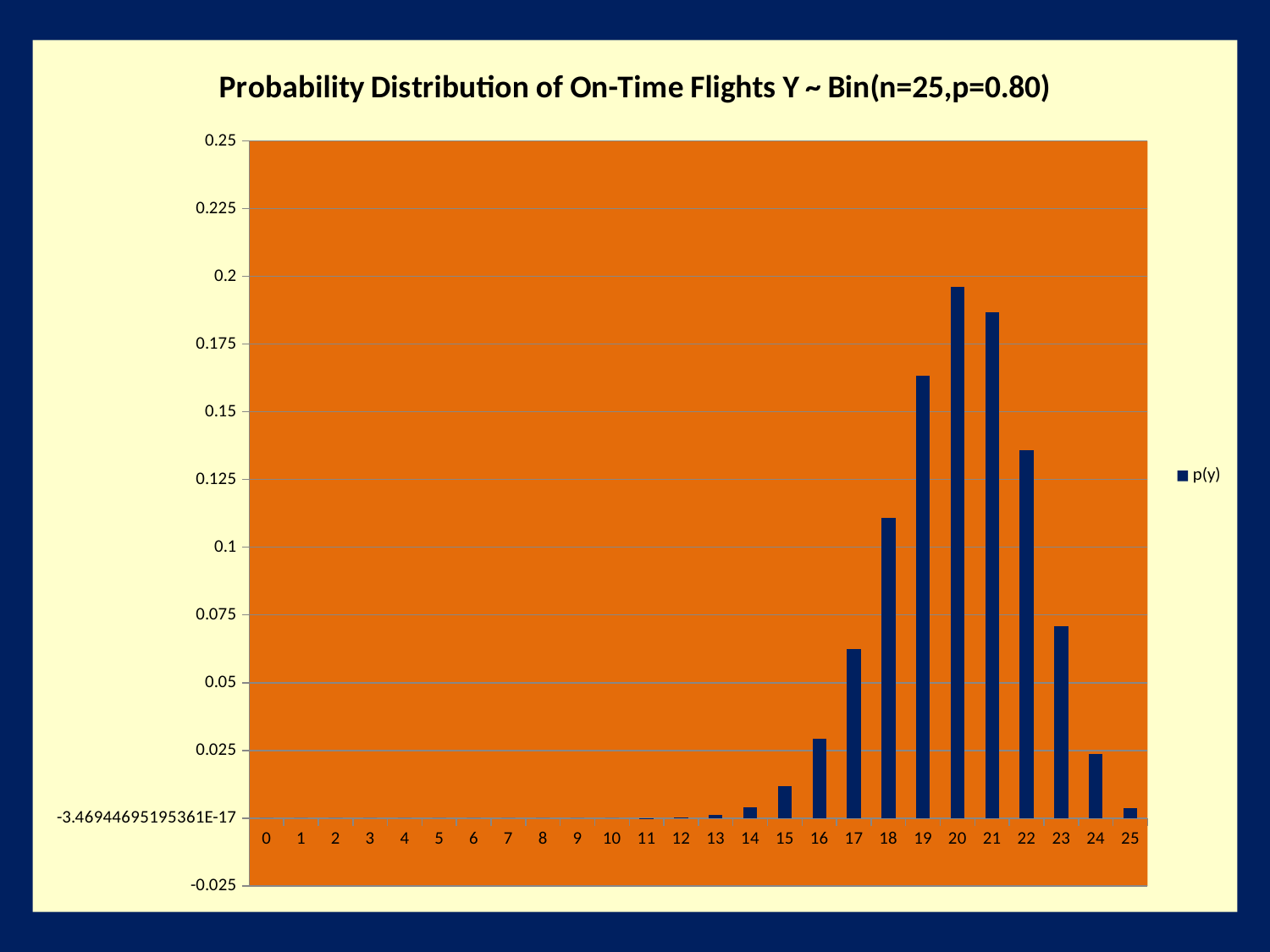
Is the value for 18 greater or less than 0.1? greater What is the name of the series shown in the legend? p(y) Is the value for 19 greater or less than 0.15? greater Is the value for 23 greater or less than 0.075? less How many series does the legend list? 1 How many categories are shown on the x axis? 26 What is the title of the chart? Probability Distribution of On-Time Flights Y ~ Bin(n=25,p=0.80) Do the values rise or fall along the x axis from 20 to 25? fall What kind of chart is shown on the slide? bar chart Which is larger, the value for 19 or the value for 21? 21 Which category has the highest value? 20